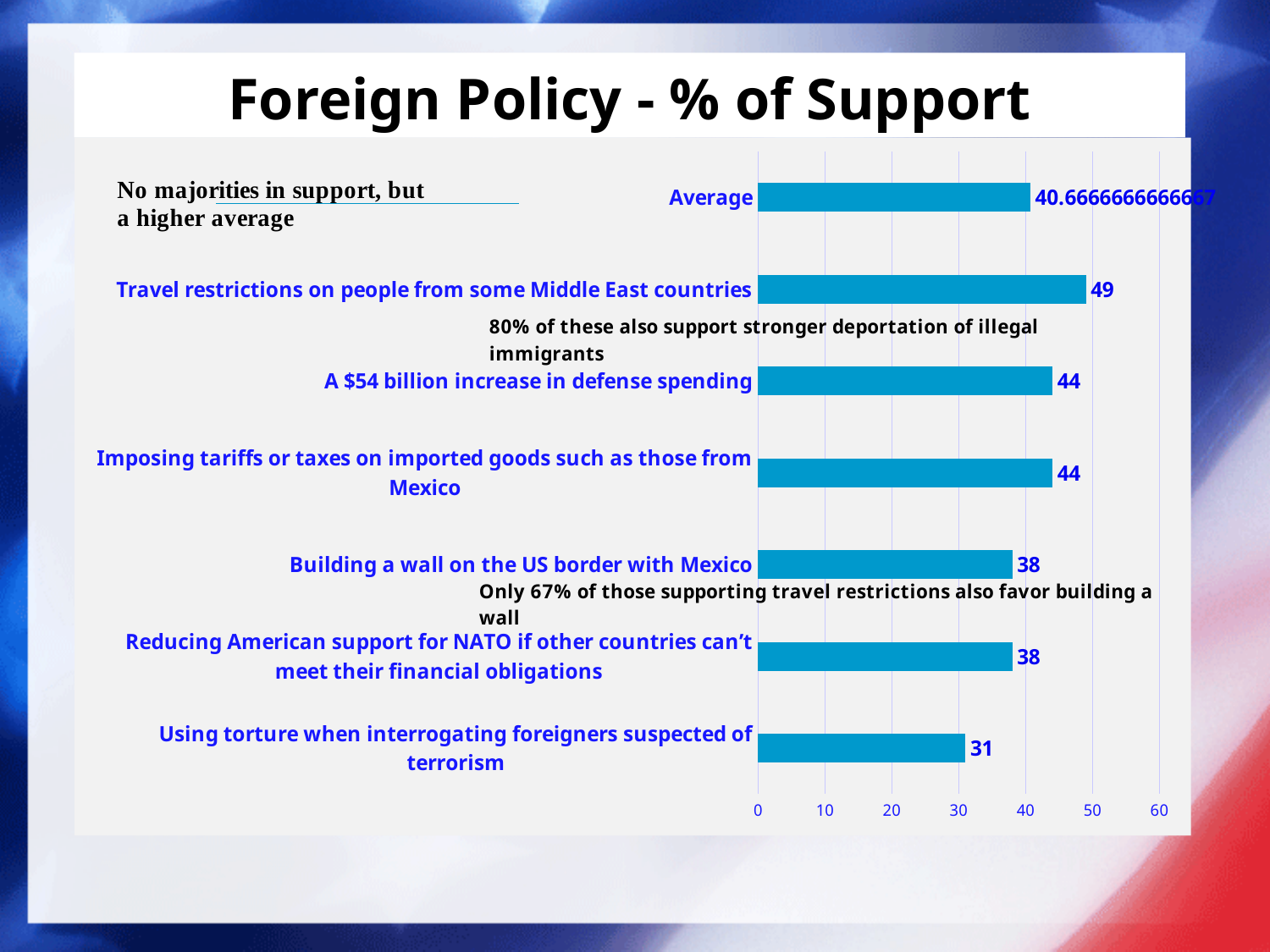
What is the % of support for travel restrictions on people from some Middle East countries? 49 What kind of chart is shown on the slide? bar chart Which has higher support: a $54 billion increase in defense spending or building a wall on the US border with Mexico? A $54 billion increase in defense spending What is the % of support for building a wall on the US border with Mexico? 38 What is the title of the chart on the slide? Foreign Policy - % of Support How many bars (categories) does the chart show, including the Average? 7 Is the value for Average greater or less than 50? less Which policy has the highest % of support? Travel restrictions on people from some Middle East countries What is the % of support for imposing tariffs or taxes on imported goods such as those from Mexico? 44 What is the difference in % of support between travel restrictions on people from some Middle East countries and using torture when interrogating foreigners suspected of terrorism? 18 What is the % of support for using torture when interrogating foreigners suspected of terrorism? 31 Which policy has the lowest % of support? Using torture when interrogating foreigners suspected of terrorism